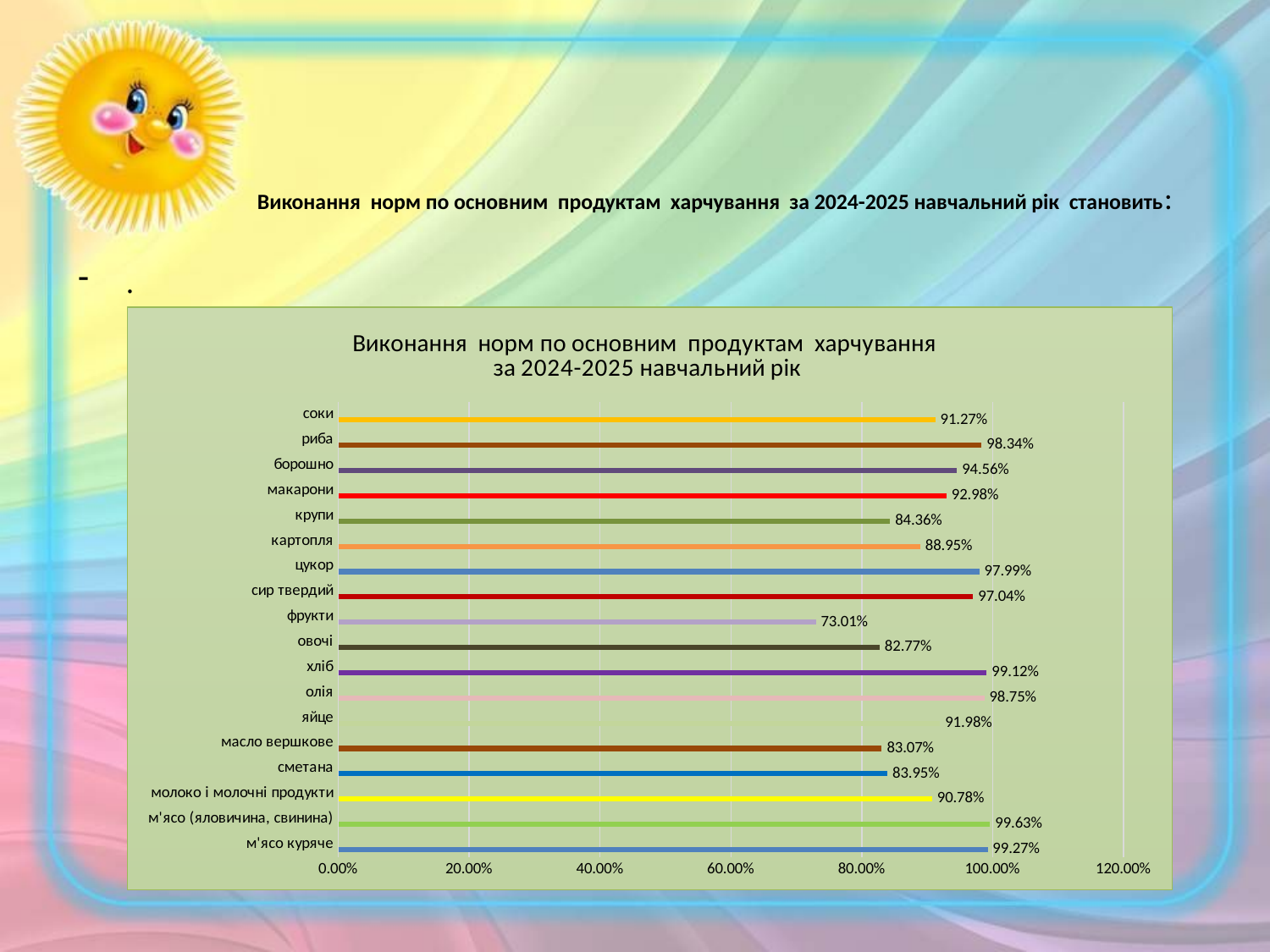
What is the value for яйце? 91.98% Which is larger, the value for крупи or the value for картопля? картопля Is the value for сметана greater or less than 80.00%? greater What type of chart is shown on the slide? bar chart What is the difference between the values for хліб and овочі? 16.35% What is the value for молоко і молочні продукти? 90.78% Which category has the highest value? м'ясо (яловичина, свинина) What is the title of the chart? Виконання норм по основним продуктам харчування за 2024-2025 навчальний рік How many categories are shown in the chart? 18 What is the value for фрукти? 73.01% Which category has the lowest value? фрукти What is the value for риба? 98.34%